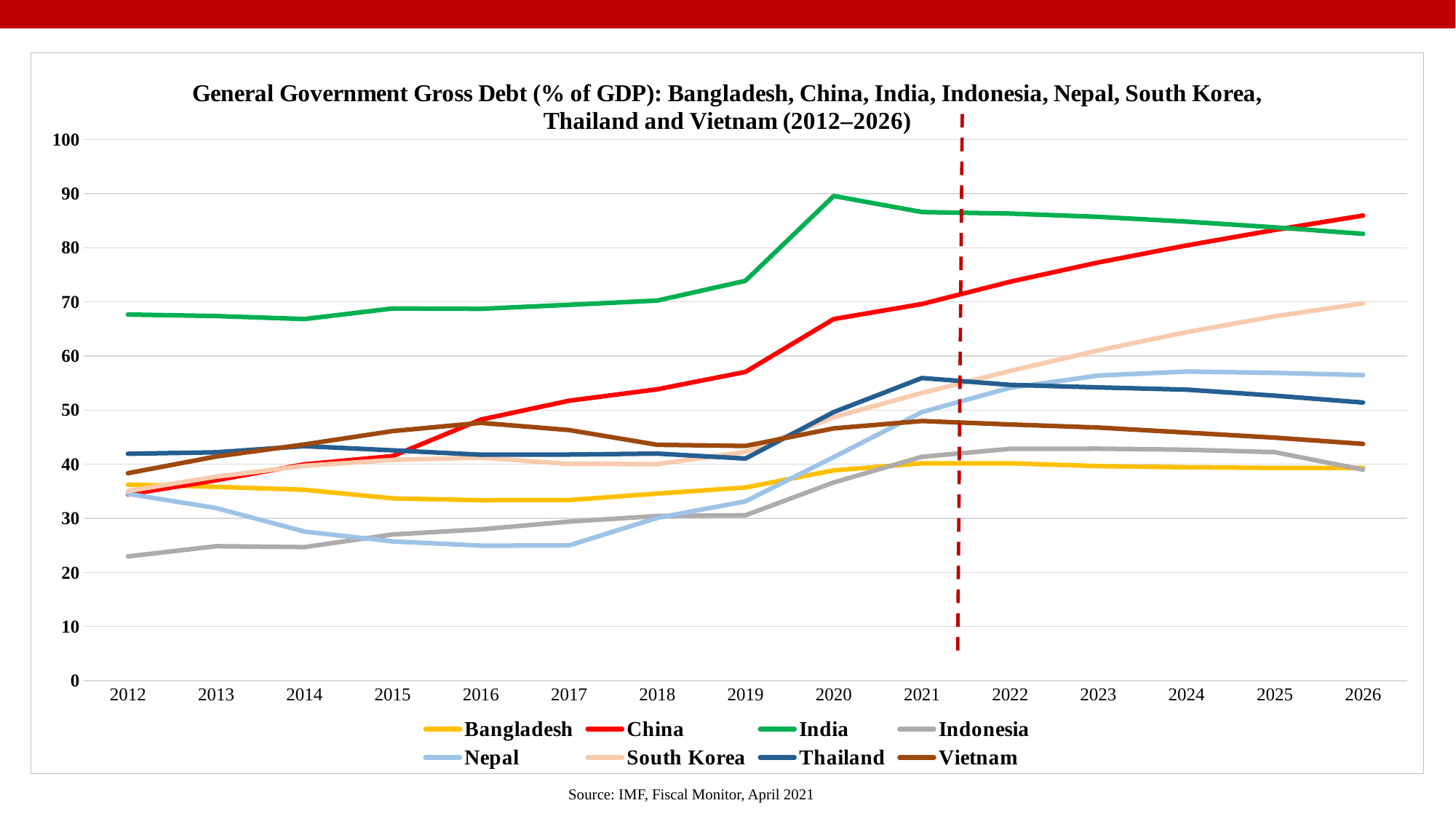
Which country has the lowest gross debt (% of GDP) in 2017? Nepal Which country has the lowest gross debt (% of GDP) in 2012? Indonesia How many series does the legend list? 8 Is the value for India in 2020 greater or less than 80? greater What kind of chart is shown on the slide? line chart In 2026, which is larger: the value for China or the value for India? China How many years are plotted along the x axis? 15 What source is cited below the chart? IMF, Fiscal Monitor, April 2021 Does the value for China rise or fall from 2012 to 2026? rise Which country has the highest gross debt (% of GDP) in 2020? India Which country has the highest gross debt (% of GDP) in 2026? China Is the value for China in 2012 greater or less than 40? less